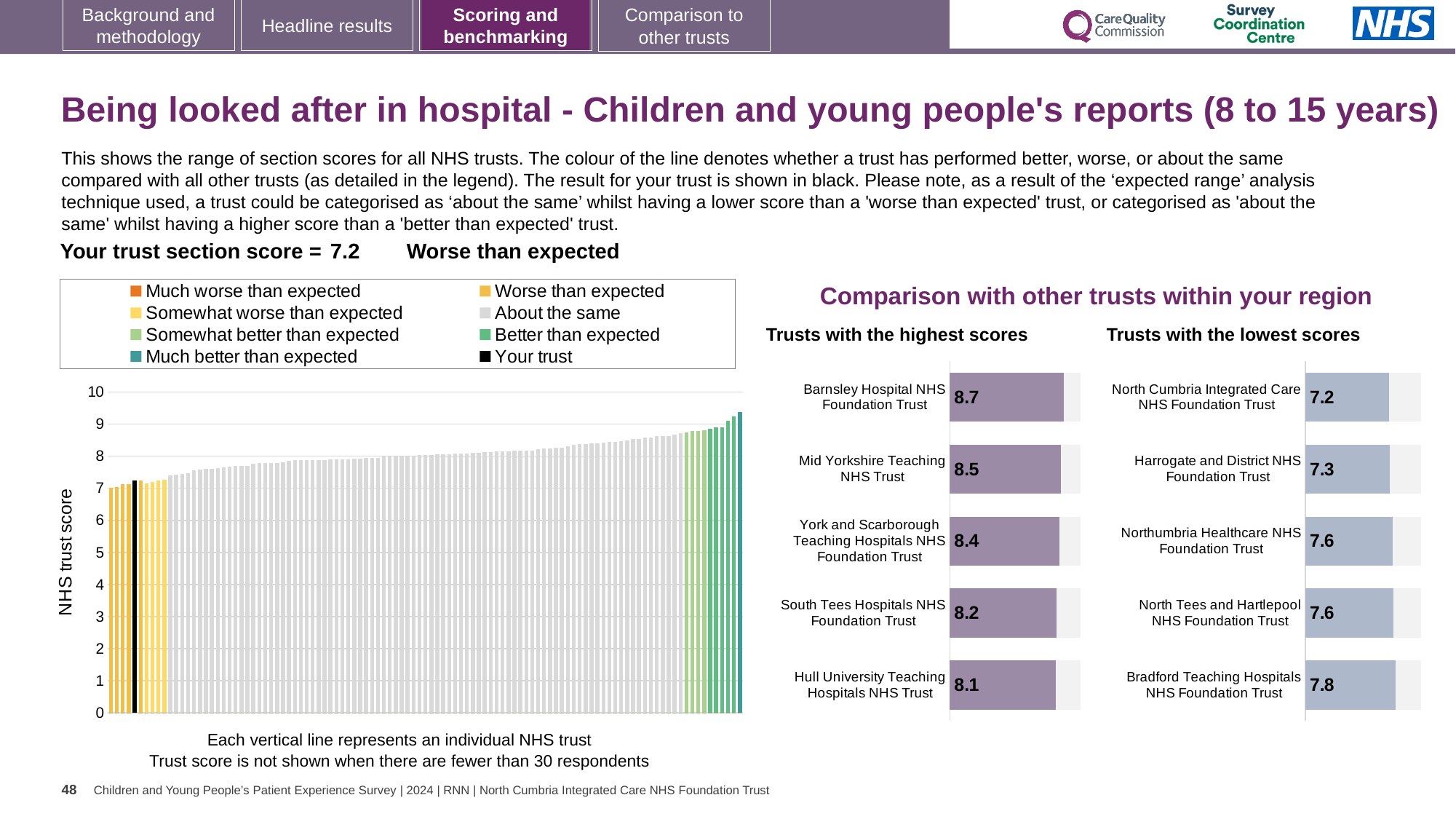
In the 'Trusts with the highest scores' chart, what is the difference between the scores of Barnsley Hospital NHS Foundation Trust and Hull University Teaching Hospitals NHS Trust? 0.6 In the 'Trusts with the lowest scores' chart, which trust has the highest score? Bradford Teaching Hospitals NHS Foundation Trust How many entries does the legend above the large chart on the left list? 8 In the 'Trusts with the lowest scores' chart, what is the score for Harrogate and District NHS Foundation Trust? 7.3 In the 'Trusts with the highest scores' chart, what is the score for Barnsley Hospital NHS Foundation Trust? 8.7 In the large chart on the left, is the value for the black 'Your trust' bar greater or less than 8? less In the 'Trusts with the highest scores' chart, which trust has the lowest score? Hull University Teaching Hospitals NHS Trust In the 'Trusts with the lowest scores' chart, which trust has the lowest score? North Cumbria Integrated Care NHS Foundation Trust In the 'Trusts with the lowest scores' chart, which has the larger score: Harrogate and District NHS Foundation Trust or Northumbria Healthcare NHS Foundation Trust? Northumbria Healthcare NHS Foundation Trust In the 'Trusts with the lowest scores' chart, what is the difference between the scores of Bradford Teaching Hospitals NHS Foundation Trust and North Cumbria Integrated Care NHS Foundation Trust? 0.6 In the 'Trusts with the highest scores' chart, how many trusts are shown? 5 What kind of chart is the large chart on the left showing NHS trust scores? Bar chart